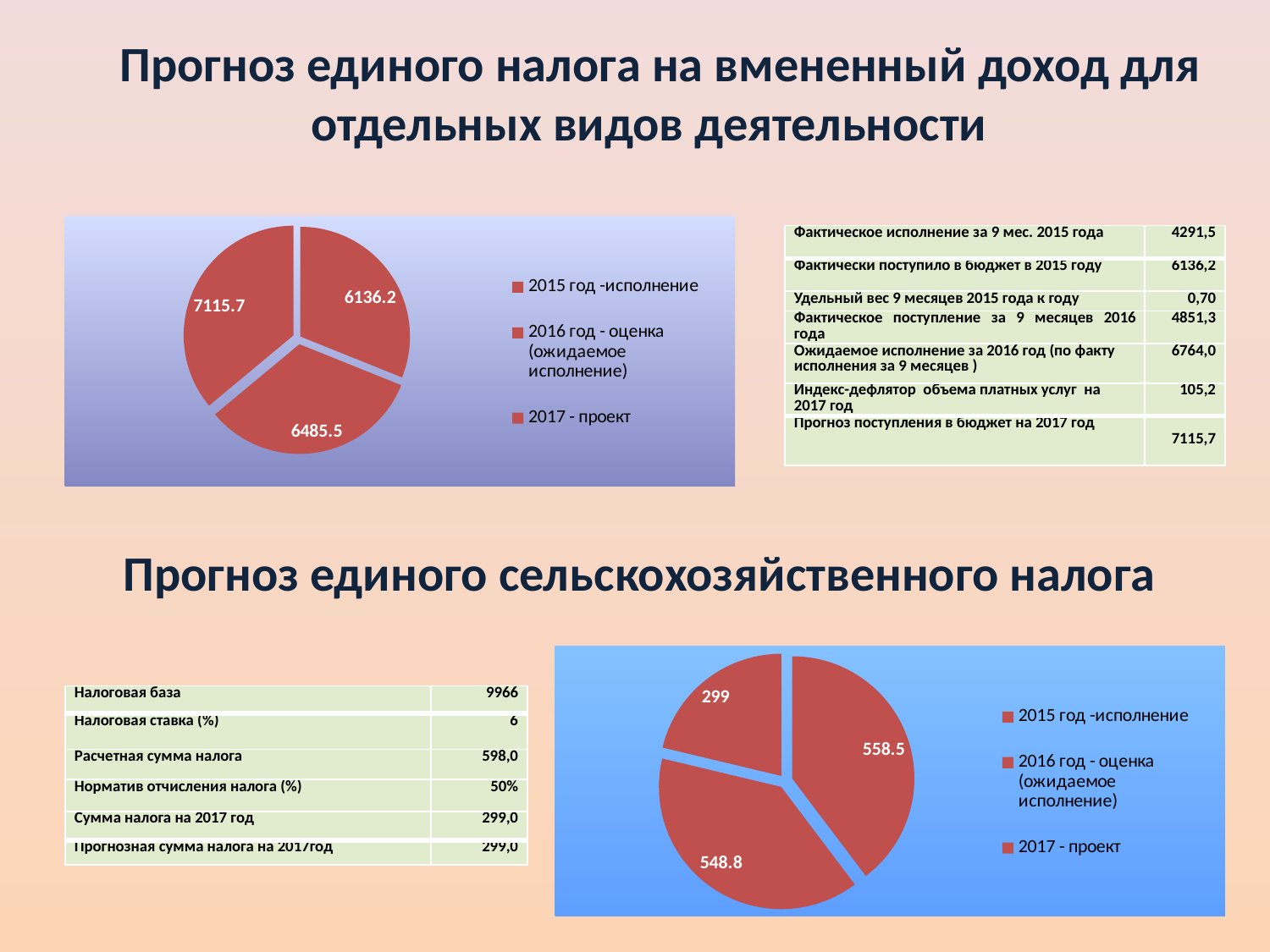
In the lower pie chart, what is the third legend entry? 2017 - проект In the upper pie chart, what is the value of the smallest slice? 6136.2 In the lower pie chart (Прогноз единого сельскохозяйственного налога), what is the value of the smallest slice? 299 How many entries does the legend of the upper pie chart list? 3 In the lower pie chart (Прогноз единого сельскохозяйственного налога), what is the value of the largest slice? 558.5 What kind of chart is the upper chart on the slide (under the title about единый налог на вмененный доход)? pie chart In the upper pie chart, what value is shown for 2017 - проект? 7115.7 In the lower pie chart, what is the difference between the slices labelled 558.5 and 548.8? 9.7 In the upper pie chart, which is larger: the slice labelled 6485.5 or the slice labelled 6136.2? 6485.5 In the upper pie chart, what is the value of the largest slice? 7115.7 In the upper pie chart, what is the difference between the largest slice (7115.7) and the smallest slice (6136.2)? 979.5 How many slices does the upper pie chart have? 3